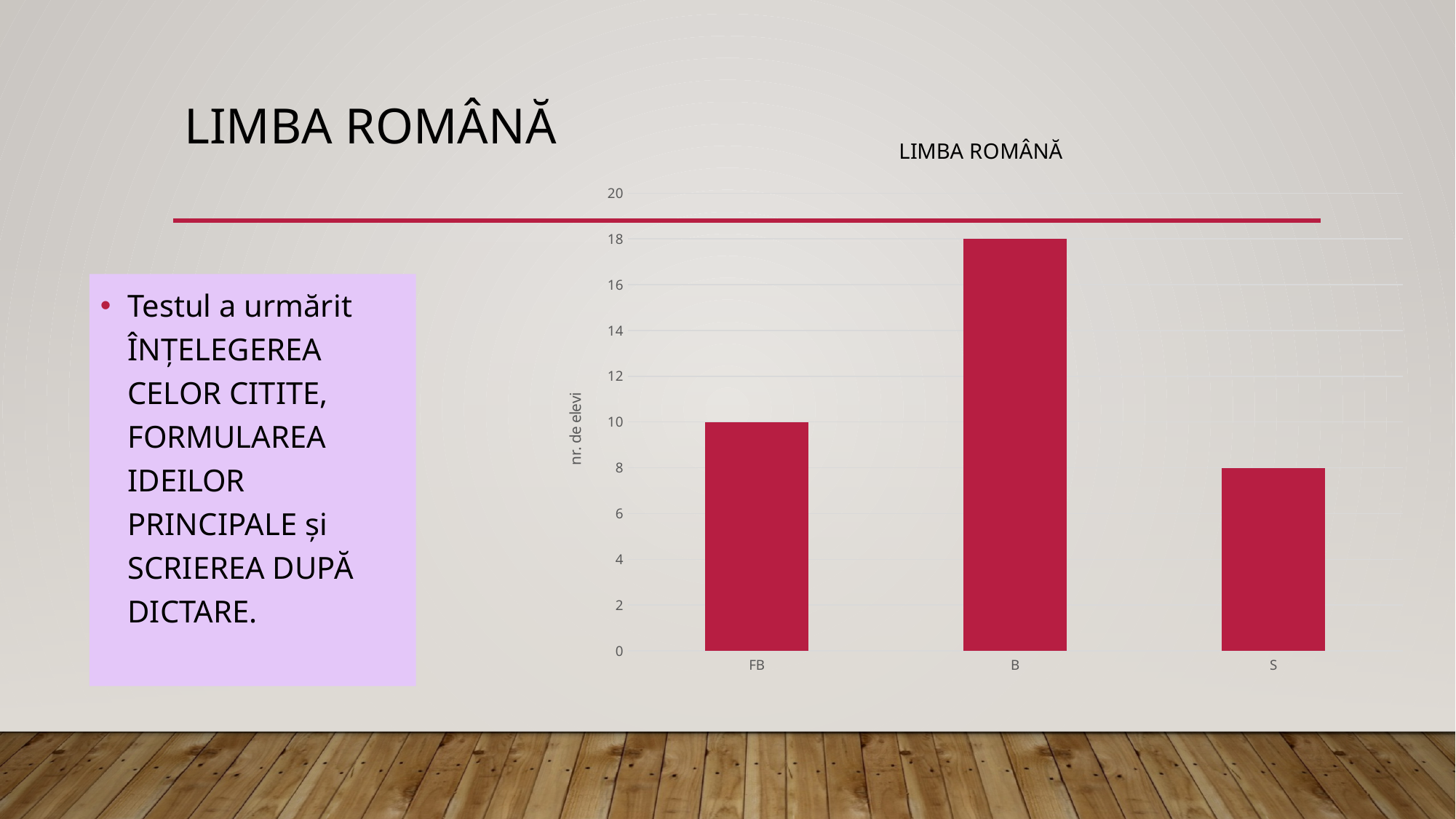
What is the value for S? 8 Is the value for B greater or less than 16? greater What is the difference between the values for B and FB? 8 What is the label of the vertical axis? nr. de elevi How many categories are shown on the x axis? 3 What kind of chart is shown on the slide? bar chart What is the difference between the values for FB and S? 2 Which category has the lowest value? S What is the value for B? 18 Which category has the highest value? B Which is larger, the value for FB or the value for S? FB What is the value for FB? 10